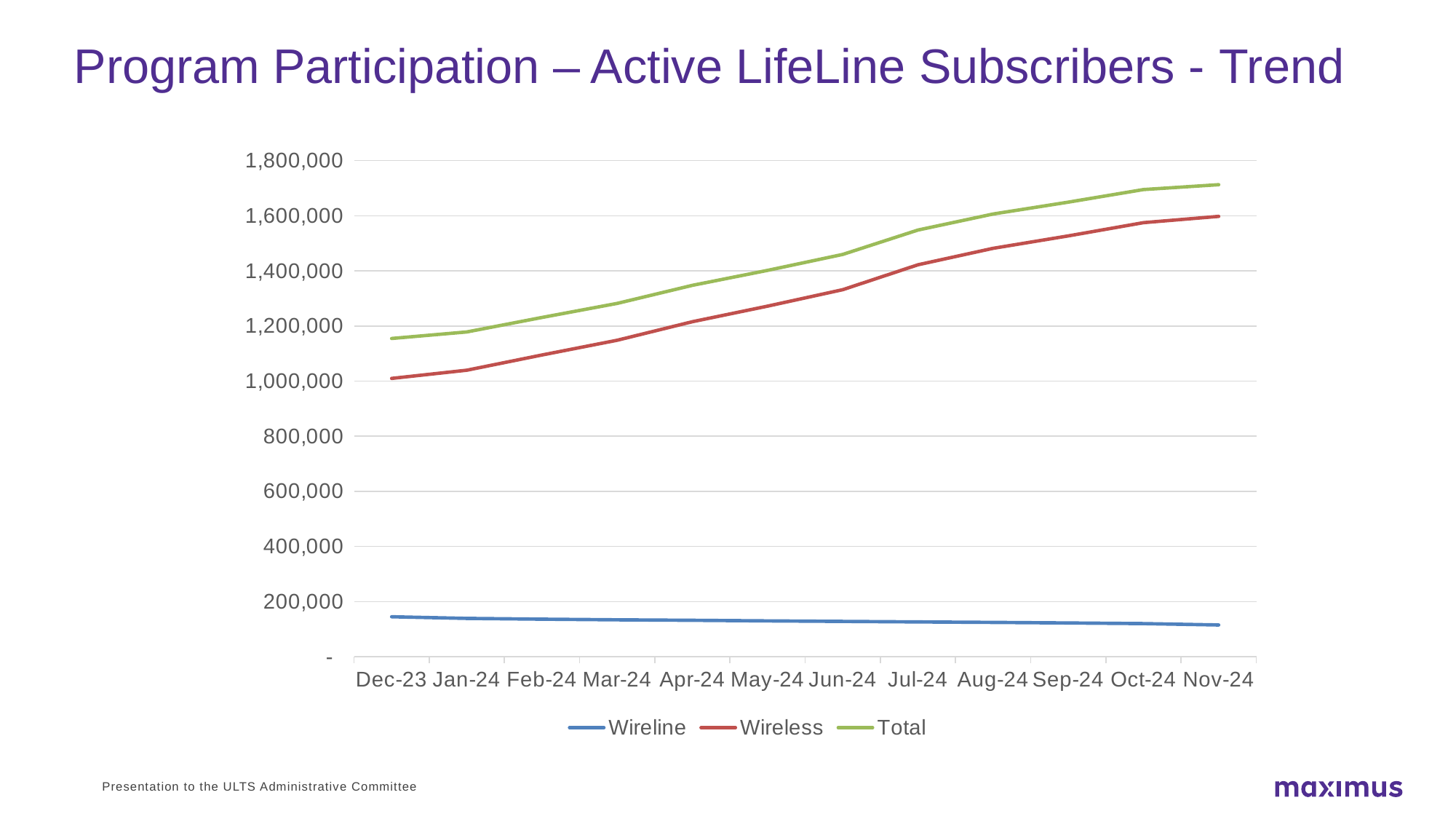
Is the Total value for Nov-24 greater or less than 1,600,000? greater Is the Wireless value for Dec-23 greater or less than 1,200,000? less Does the Wireless series rise or fall from Dec-23 to Nov-24? rise Is the Wireline value for Dec-23 greater or less than 200,000? less How many months are plotted along the x axis? 12 Does the Wireline series rise or fall from Dec-23 to Nov-24? fall What kind of chart is shown on the slide? line chart In Jun-24, which is larger, the Wireless value or the Wireline value? Wireless In which month is the Total series at its highest? Nov-24 How many series does the legend list? 3 In which month is the Wireless series at its lowest? Dec-23